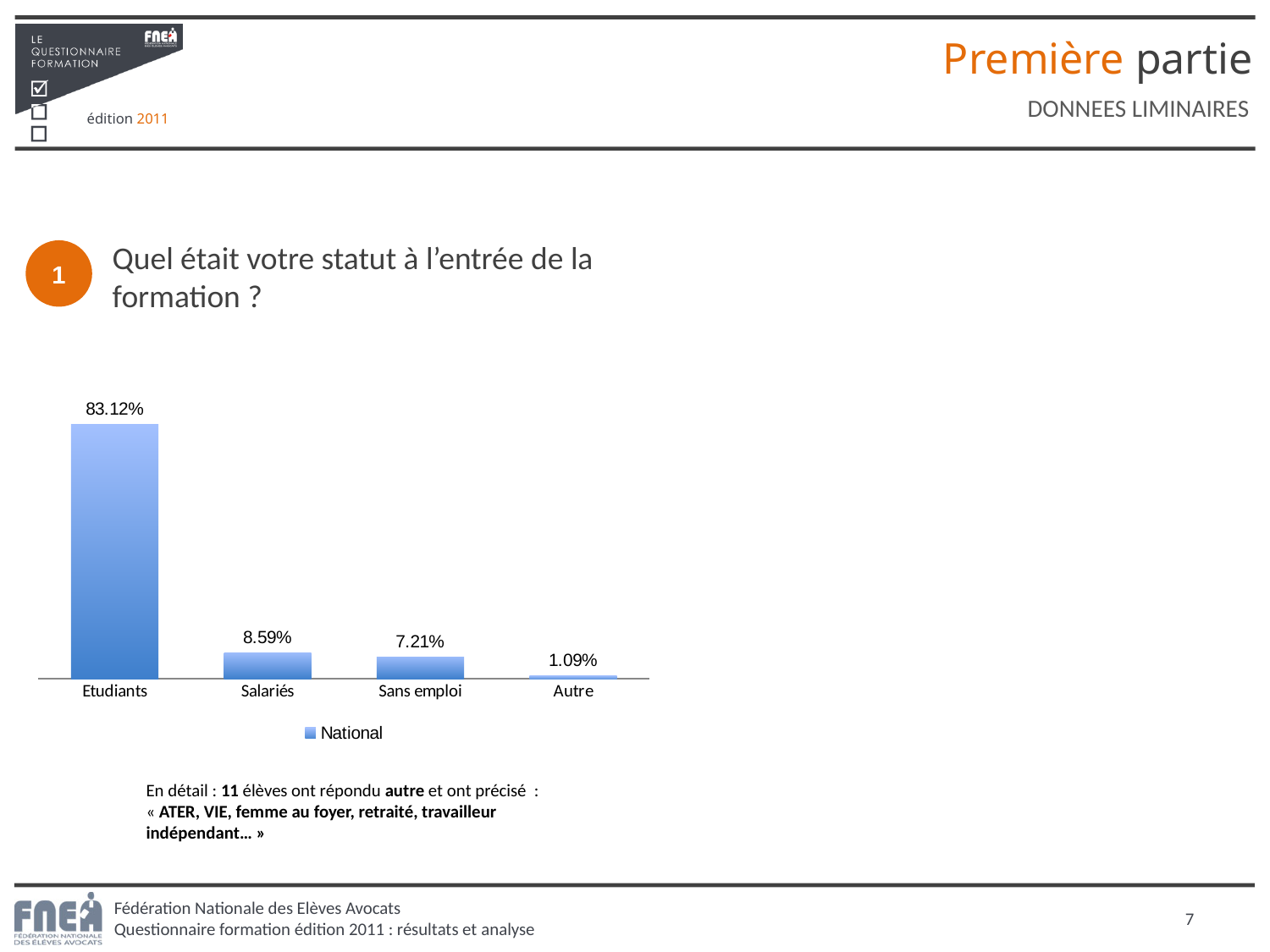
What is the value for Sans emploi? 7.21% Which category has the highest value? Etudiants What is the value for Etudiants? 83.12% Which category has the lowest value? Autre What is the difference between the values for Salariés and Sans emploi? 1.38% How many categories are shown on the x axis? 4 What kind of chart is shown on the slide? bar chart What is the difference between the values for Etudiants and Salariés? 74.53% What is the value for Autre? 1.09% Which is larger, the value for Salariés or the value for Autre? Salariés What is the value for Salariés? 8.59% How many series does the legend list? 1